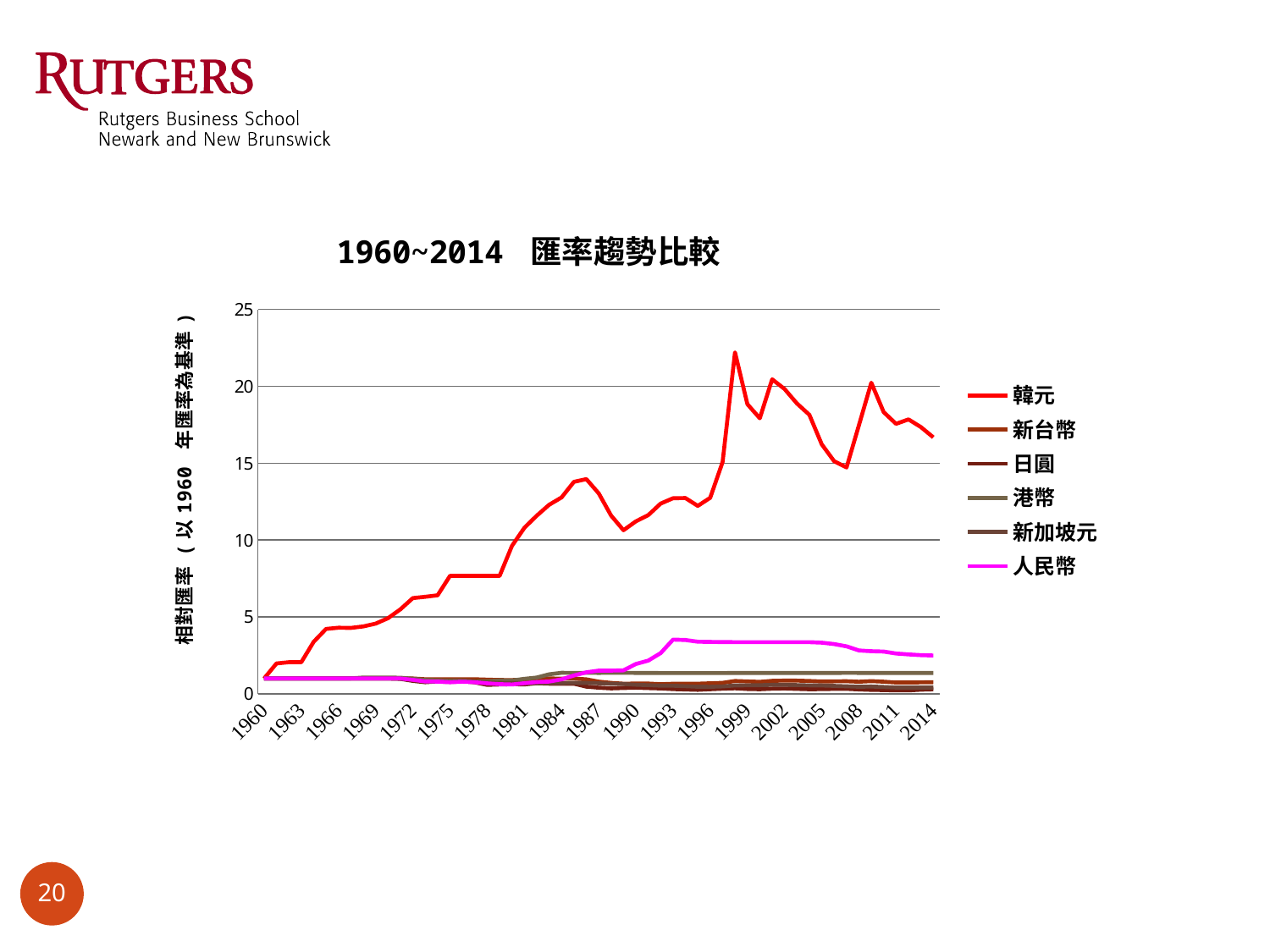
Is the value for 人民幣 in 2014 greater or less than 5? less Is the value for 韓元 in 2014 greater or less than 15? greater Is the peak value for 韓元 around 1998 greater or less than 20? greater Does the value for 韓元 rise or fall from 1960 to 1984? rise In 2014, which is larger, the value for 韓元 or the value for 人民幣? 韓元 What is the title of the chart? 1960~2014 匯率趨勢比較 What kind of chart is shown on the slide? line chart Does the value for 韓元 rise or fall from 2011 to 2014? fall Which series is plotted in red? 韓元 Which series reaches the highest value on the chart? 韓元 How many series does the legend list? 6